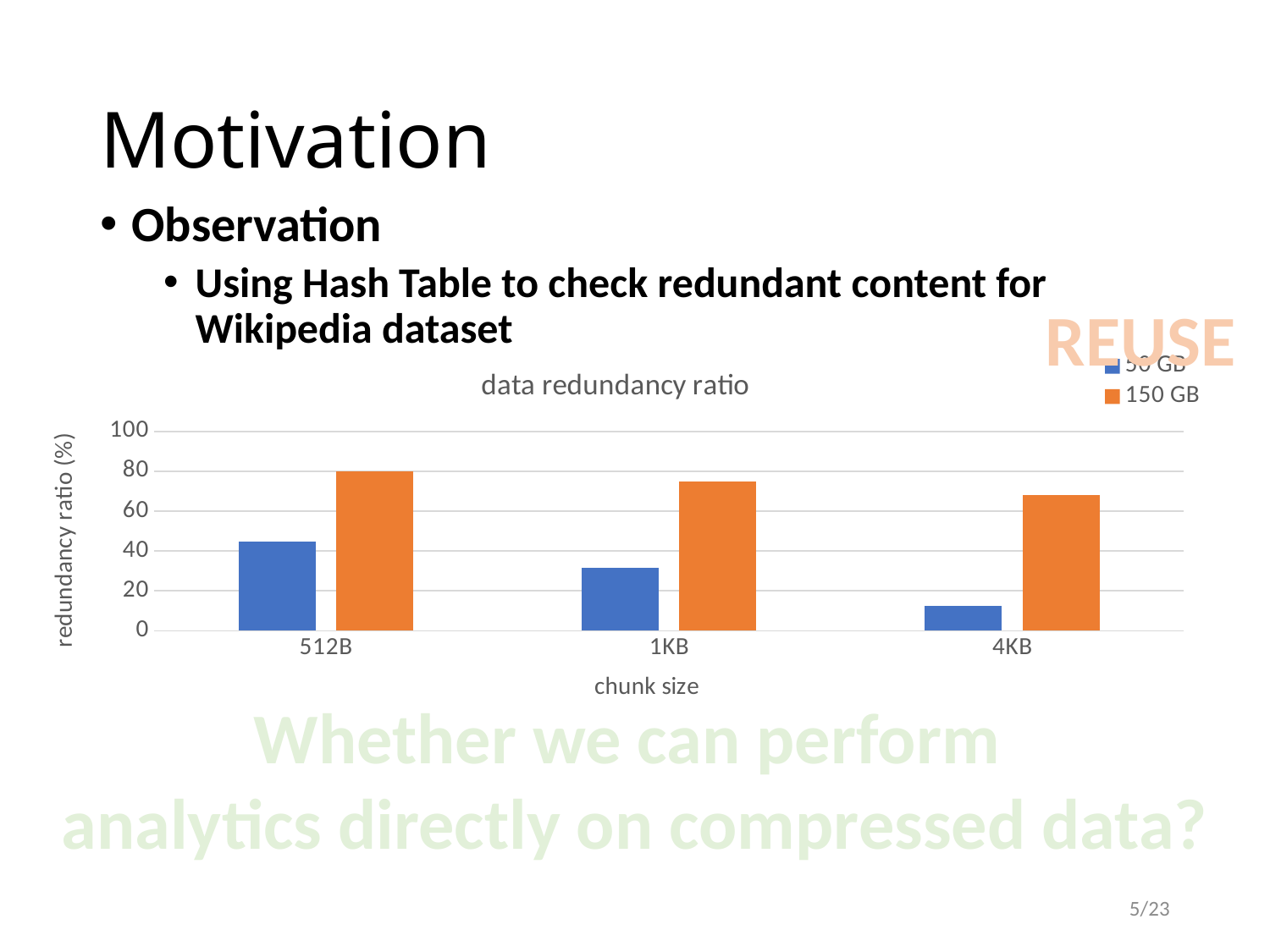
Is the value of the blue bar for 4KB greater or less than 20? less Is the value of the 150 GB bar for 1KB greater or less than 60? greater Is the value of the 150 GB bar for 512B greater or less than 60? greater What kind of chart is shown on the slide? bar chart How many chunk size categories are shown on the x axis of the chart? 3 How many series does the chart's legend list? 2 At 4KB, which is larger: the blue bar or the 150 GB bar? 150 GB Which chunk size has the highest 150 GB redundancy ratio? 512B Which chunk size has the lowest value for the blue series? 4KB Do the blue bars rise or fall as chunk size increases from 512B to 4KB? fall What is the title of the chart? data redundancy ratio